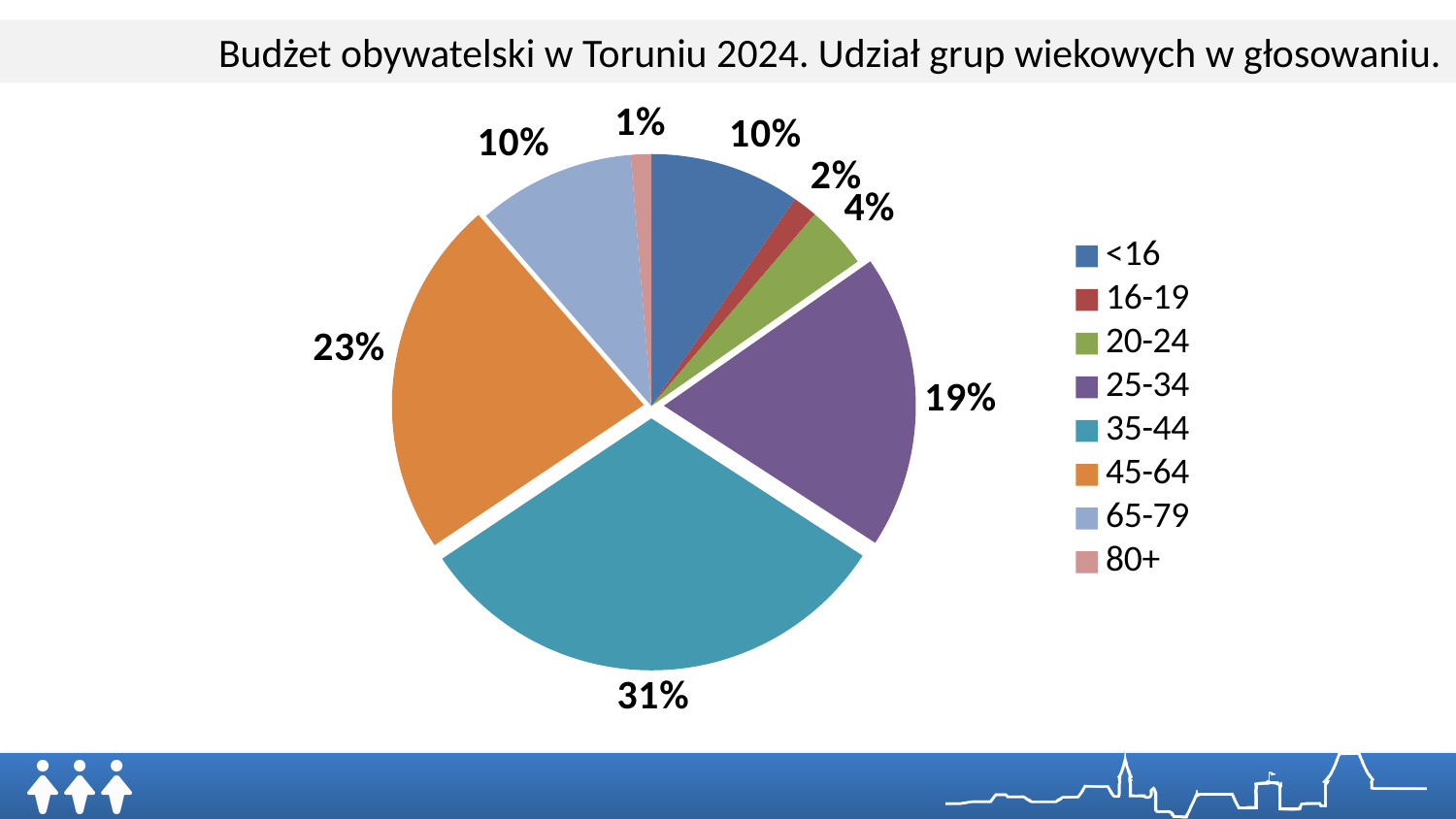
What is the difference between the shares of the 35-44 and 45-64 age groups? 8 percentage points Which has a larger share, the 20-24 group or the 65-79 group? 65-79 What share of the vote does the 35-44 age group have? 31% Which age group has the largest share of the vote? 35-44 What share of the vote does the 25-34 age group have? 19% What share of the vote does the 45-64 age group have? 23% Which age group has the smallest share of the vote? 80+ What kind of chart is shown on the slide? pie chart What is the title of the chart? Budżet obywatelski w Toruniu 2024. Udział grup wiekowych w głosowaniu. How many age groups does the legend list? 8